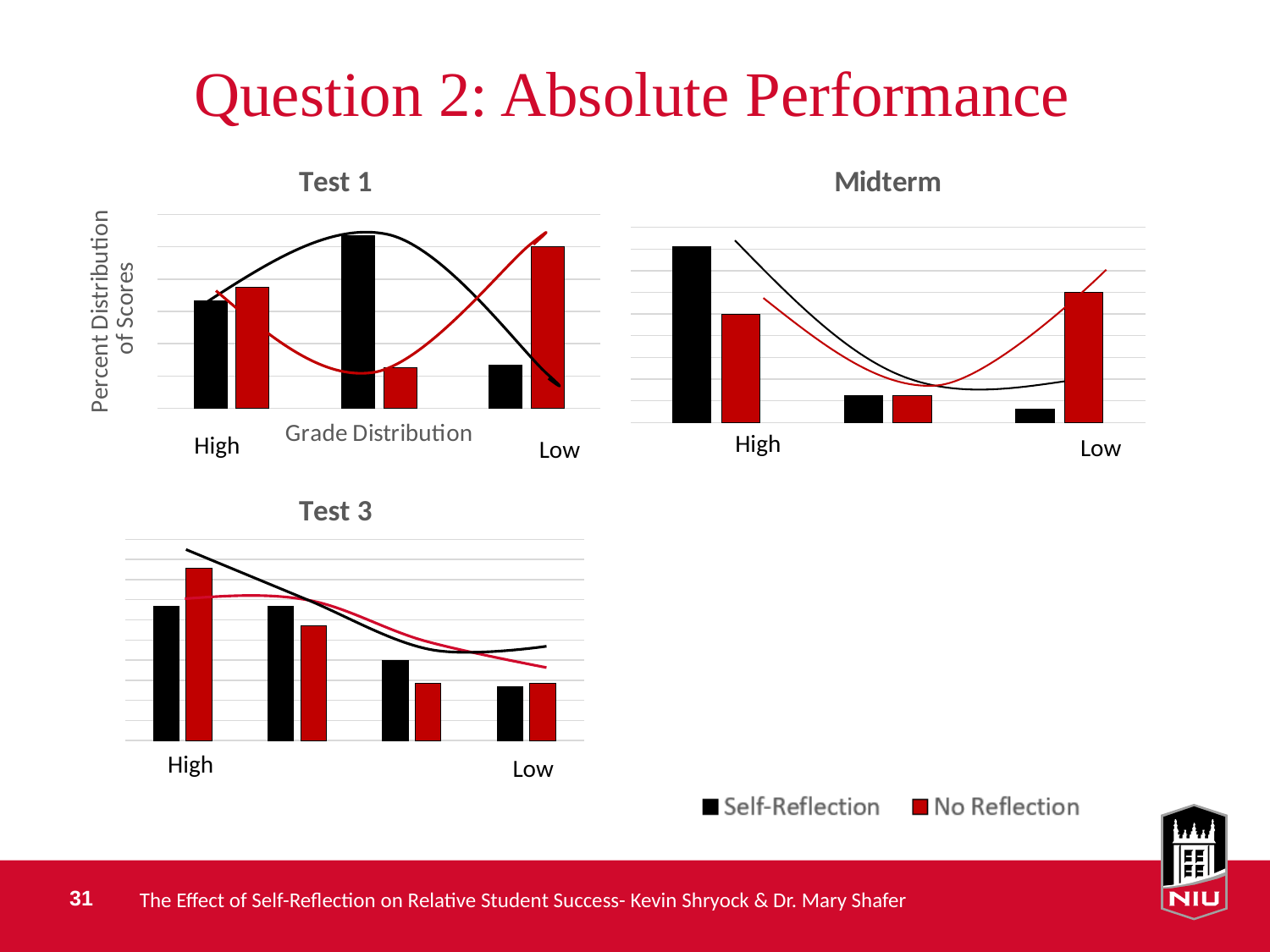
In the Midterm chart, which series has the taller bar at High, Self-Reflection or No Reflection? Self-Reflection What kind of chart is the Test 1 chart? bar chart How many groups of bars does the Test 3 chart show? 4 What is the y-axis title on the Test 1 chart? Percent Distribution of Scores In the Test 1 chart, which series has the taller bar at Low, Self-Reflection or No Reflection? No Reflection In the Test 3 chart, which series has the taller bar at High, Self-Reflection or No Reflection? No Reflection In the Test 3 chart, do the Self-Reflection bars rise or fall from High to Low? fall How many groups of bars does the Midterm chart show? 3 In the Test 1 chart, which group of bars contains the tallest Self-Reflection bar? the middle group Which colour represents the No Reflection series? red How many series does the legend list? 2